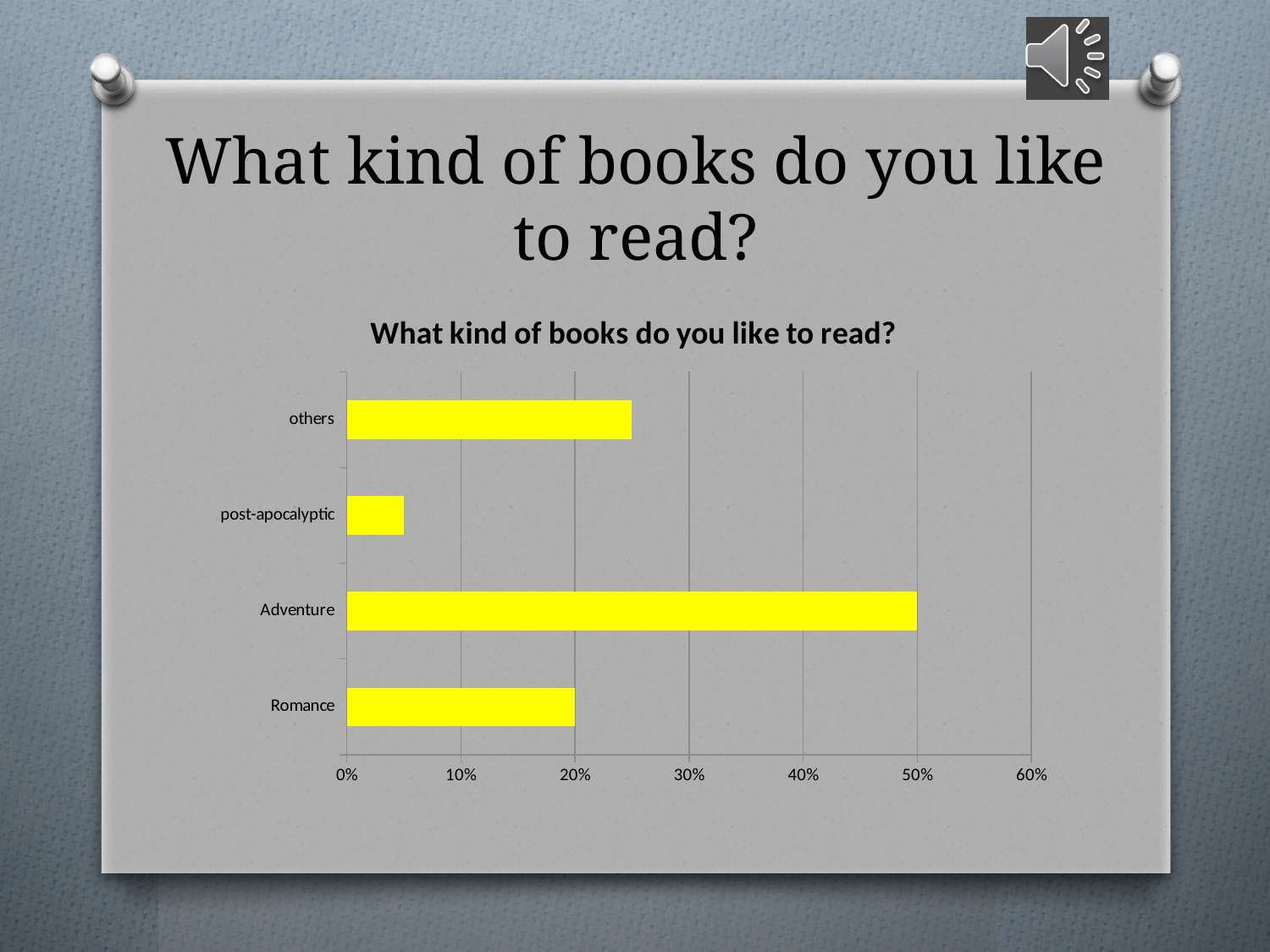
What is the difference between the values for Adventure and Romance? 30% What is the value for Romance? 20% What is the value for Adventure? 50% What is the title of the chart? What kind of books do you like to read? Is the value for post-apocalyptic greater or less than 10%? less Which category has the lowest value? post-apocalyptic What kind of chart is shown on the slide? Bar chart What colour are the bars in the chart? Yellow How many categories are shown in the chart? 4 Is the value for others greater or less than 20%? greater Which is larger, the value for others or the value for Romance? others Which category has the highest value? Adventure